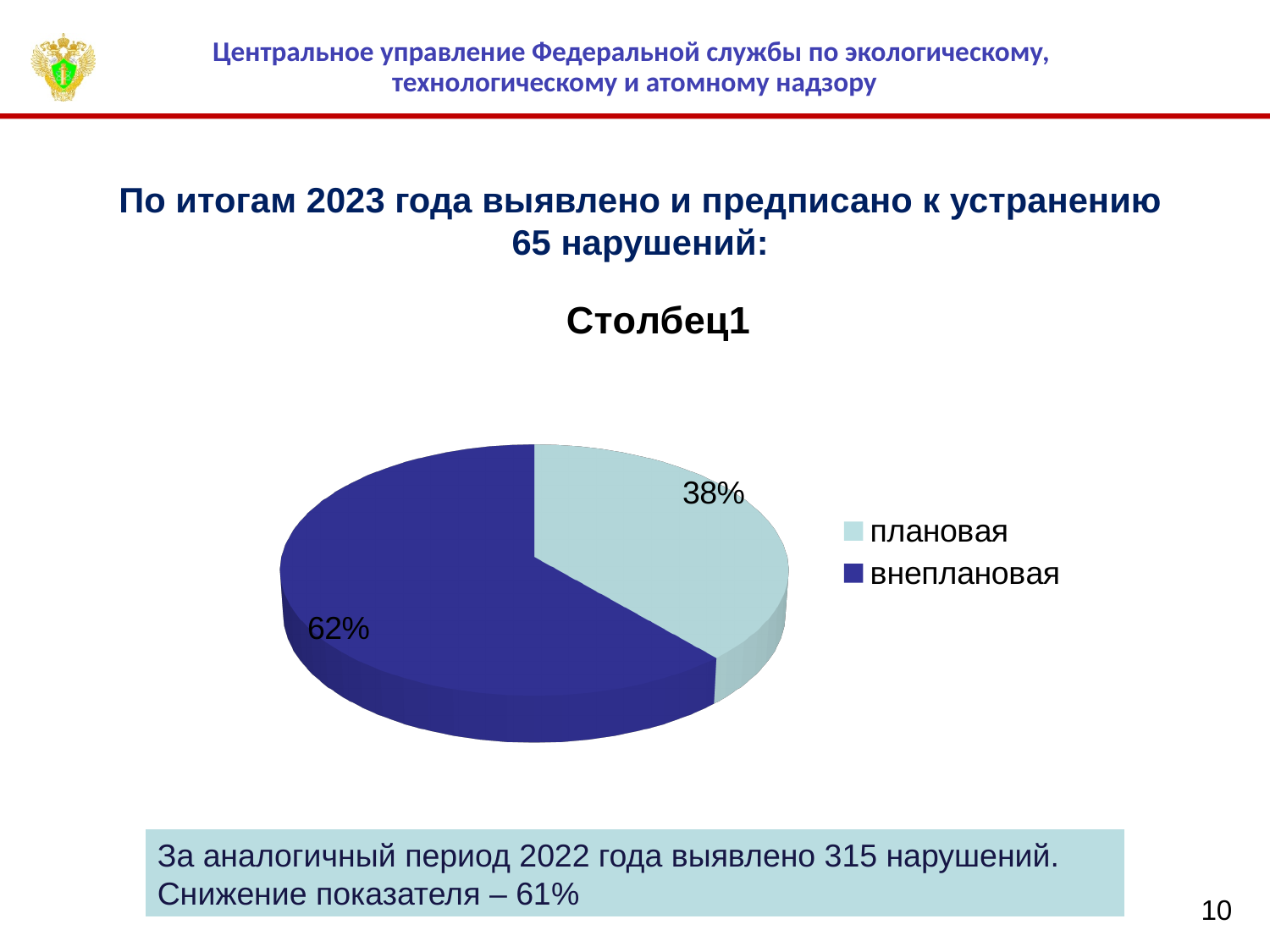
What is the difference in percentage points between the 'внеплановая' and 'плановая' slices? 24% Which is larger, the 'плановая' slice or the 'внеплановая' slice? внеплановая Which slice is the smallest in the pie chart? плановая How many entries does the legend list? 2 What kind of chart is shown on the slide? pie chart Which slice is the largest in the pie chart? внеплановая What share of the pie does the 'плановая' slice represent? 38% What share of the pie does the 'внеплановая' slice represent? 62% What is the title of the chart? Столбец1 How many slices does the pie chart have? 2 What colour is the 'внеплановая' slice? dark blue